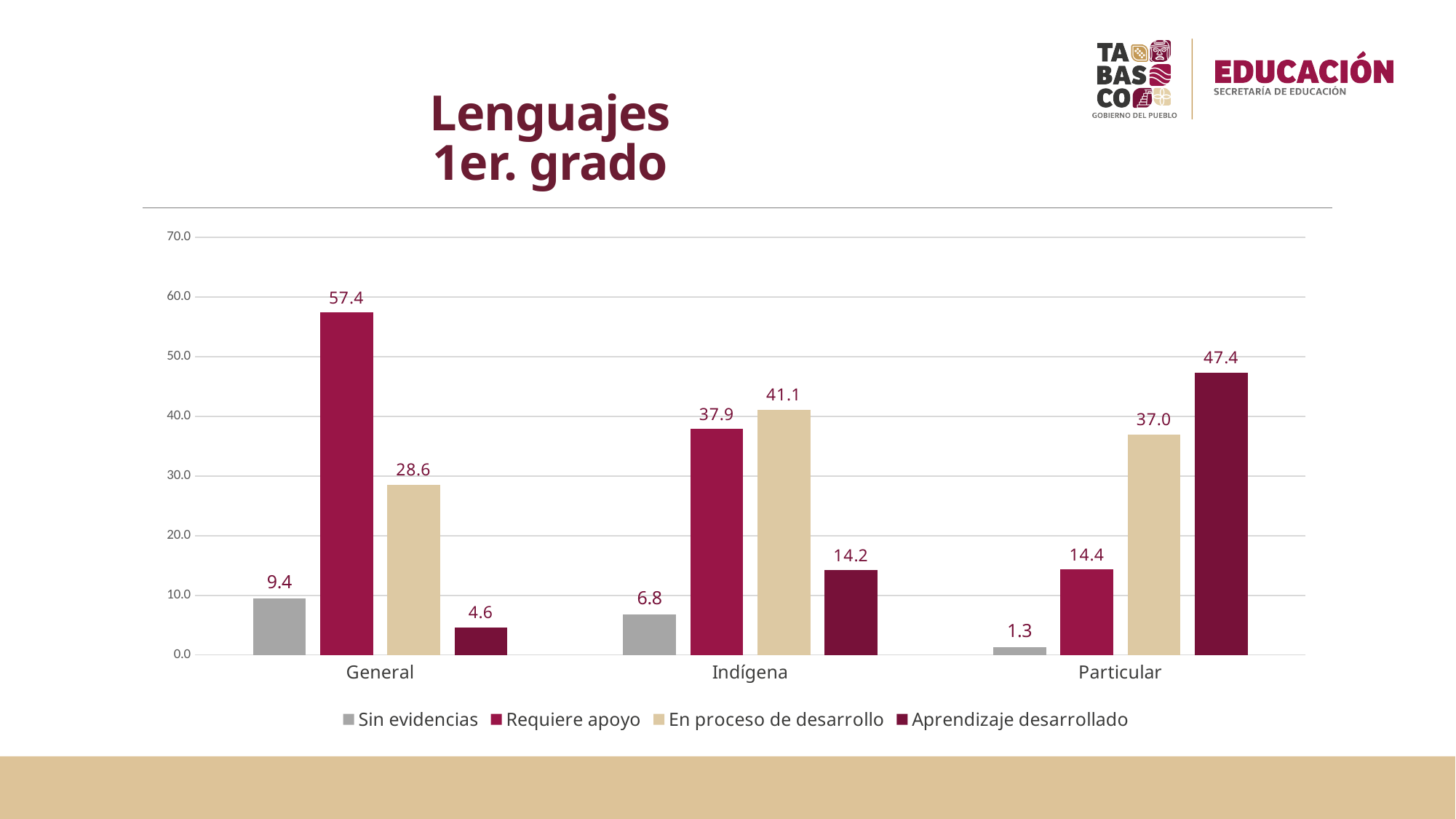
What is the value for Sin evidencias in the Particular category? 1.3 Which is larger in the Indígena category: Requiere apoyo or En proceso de desarrollo? En proceso de desarrollo How many series does the legend list? 4 What is the value for En proceso de desarrollo in the Indígena category? 41.1 What kind of chart is shown on the slide? Bar chart What is the value for Aprendizaje desarrollado in the Particular category? 47.4 What is the title of the slide? Lenguajes 1er. grado What is the difference between Requiere apoyo and Aprendizaje desarrollado in the General category? 52.8 Which category has the lowest value for Sin evidencias? Particular Which category has the highest value for Aprendizaje desarrollado? Particular What is the value for Requiere apoyo in the General category? 57.4 How many categories are shown on the x axis? 3